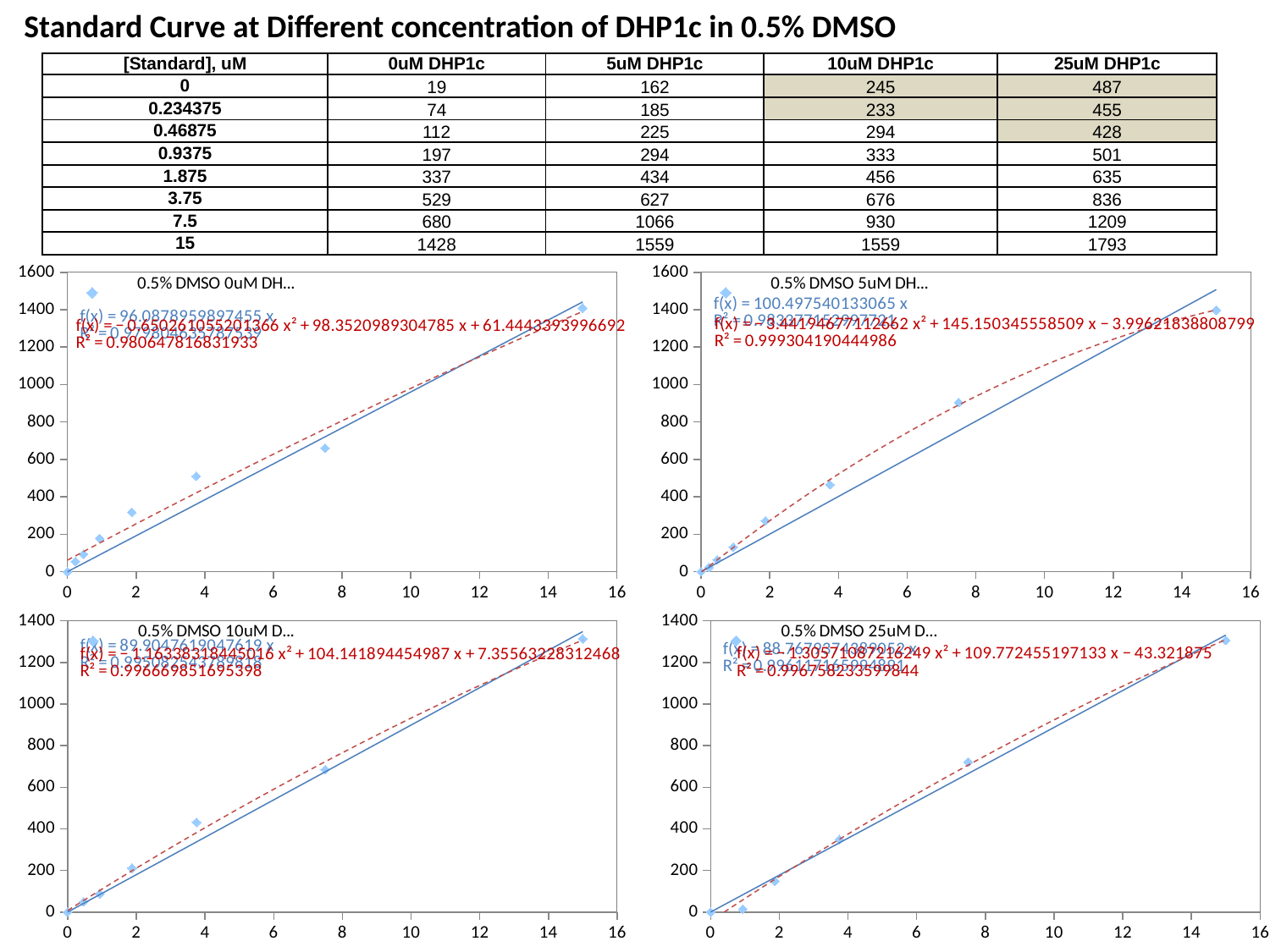
In the top-right chart (0.5% DMSO 5uM), what R² value is shown in red for the polynomial trendline? 0.999304190444986 In the top-left chart (0.5% DMSO 0uM), do the plotted values rise or fall as x increases from 0 to 15? rise In the top-right chart (0.5% DMSO 5uM), is the value of the point at x = 15 greater or less than 1200? greater In the top-left chart (0.5% DMSO 0uM), what is the blue linear trendline equation shown? f(x) = 96.0878959897455 x In the top-left chart (0.5% DMSO 0uM), is the value of the point at x = 7.5 greater or less than 600? greater In the bottom-right chart (0.5% DMSO 25uM), do the plotted values rise or fall as x increases? rise In the top-left chart (0.5% DMSO 0uM), is the value of the point at x = 15 greater or less than 1200? greater What kind of chart is the top-left chart titled "0.5% DMSO 0uM DH..."? scatter chart